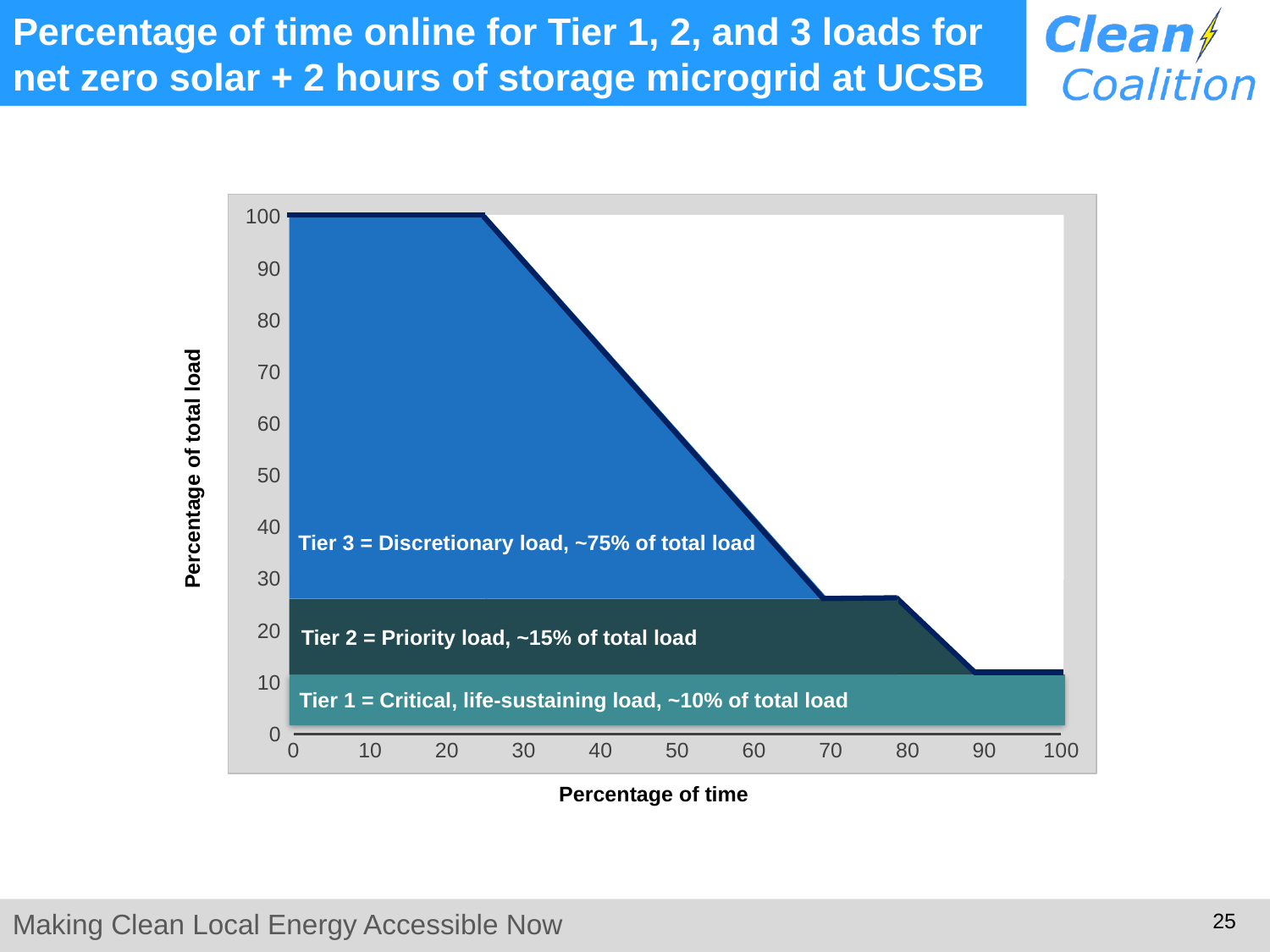
Is the percentage of total load at 70% of time greater or less than 20? greater Is the percentage of total load at 90% of time greater or less than 20? less Which is larger, the percentage of total load at 20% of time or at 80% of time? 20% of time What kind of chart is shown on the slide? area chart What is the percentage of total load at 10% of time? 100 Is the percentage of total load at 60% of time greater or less than 50? less What is the percentage of total load at 0% of time? 100 How many load tiers are labelled on the chart? 3 What is the title of the y axis? Percentage of total load Do the values rise or fall as the percentage of time increases along the x axis? fall What is the title of the x axis? Percentage of time